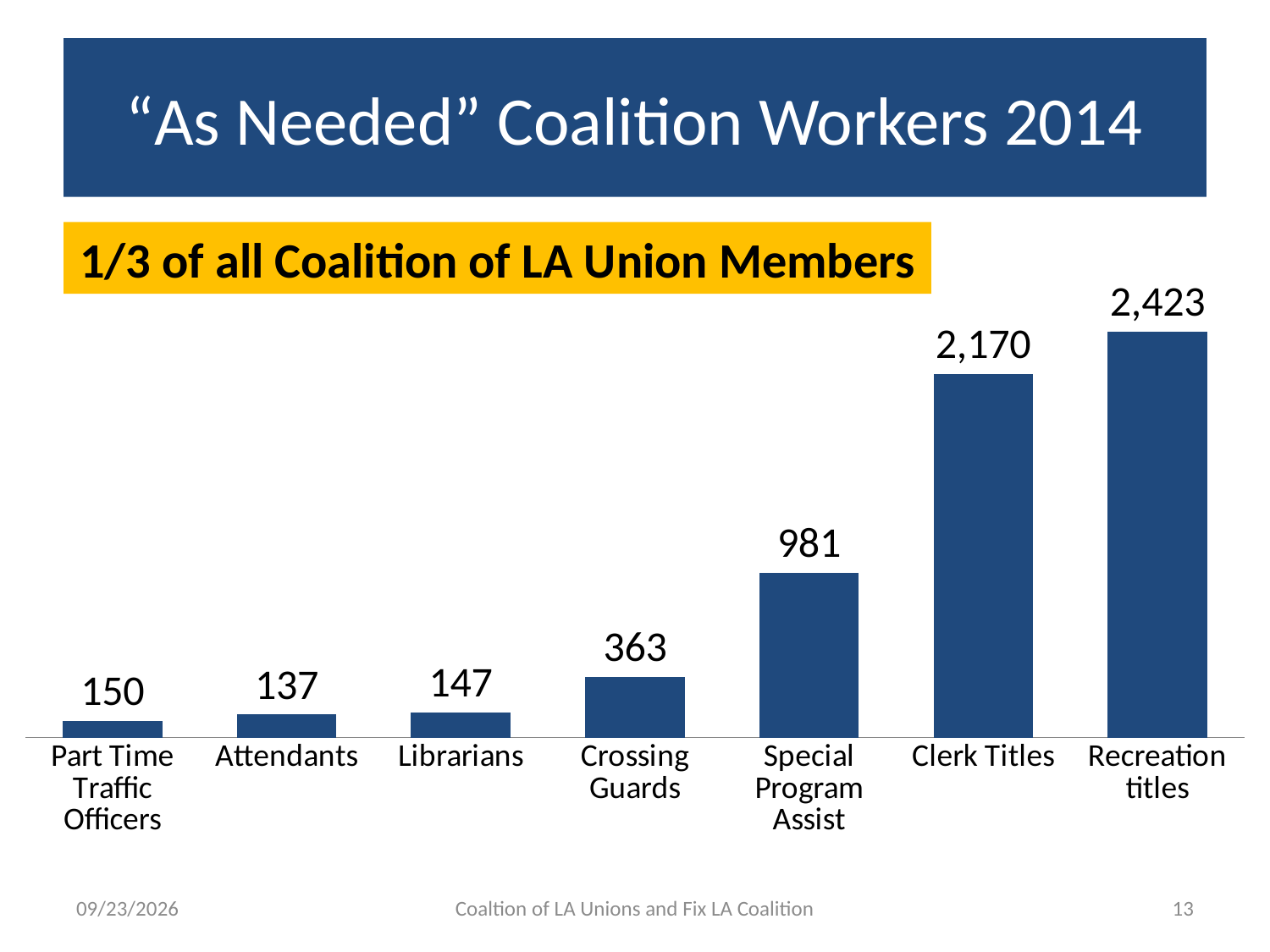
What is the value for Clerk Titles? 2,170 What is the value for Special Program Assist? 981 What is the difference between Special Program Assist and Crossing Guards? 618 Do the values generally rise or fall from left to right across the chart? Rise What is the value for Crossing Guards? 363 What is the title of the slide containing the chart? "As Needed" Coalition Workers 2014 How many categories are shown in the chart? 7 Which category has the highest value? Recreation titles What kind of chart is shown on the slide? Bar chart What is the difference between Recreation titles and Clerk Titles? 253